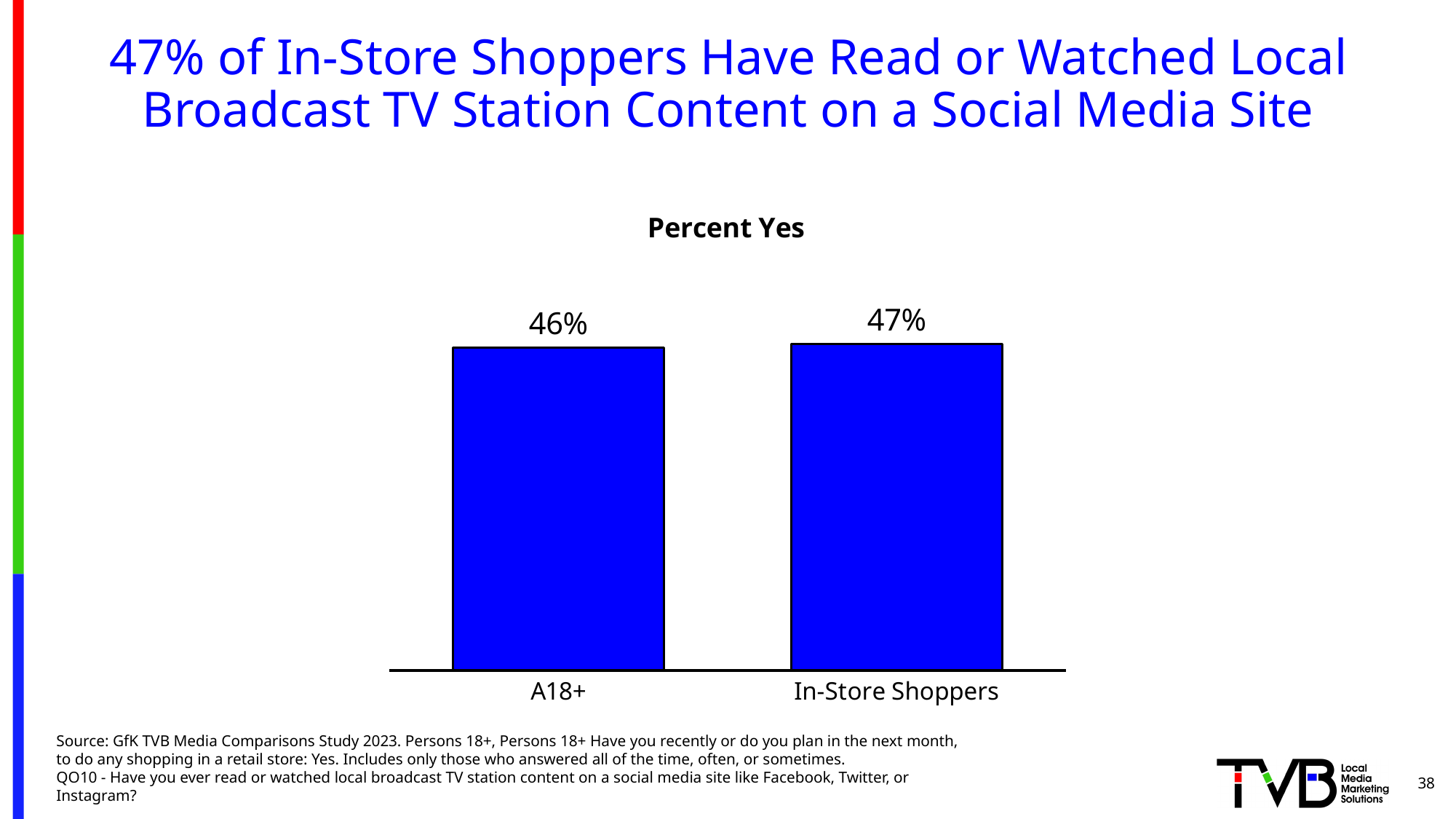
Which category has the lowest value? A18+ What is the difference between the values for In-Store Shoppers and A18+? 1% What is the value for A18+? 46% Which category has the highest value? In-Store Shoppers What is the value for In-Store Shoppers? 47% What colour are the bars in the chart? Blue What kind of chart is shown on the slide? Bar chart What is the title of the chart? Percent Yes Which is larger, the value for A18+ or the value for In-Store Shoppers? In-Store Shoppers How many categories are shown in the chart? 2